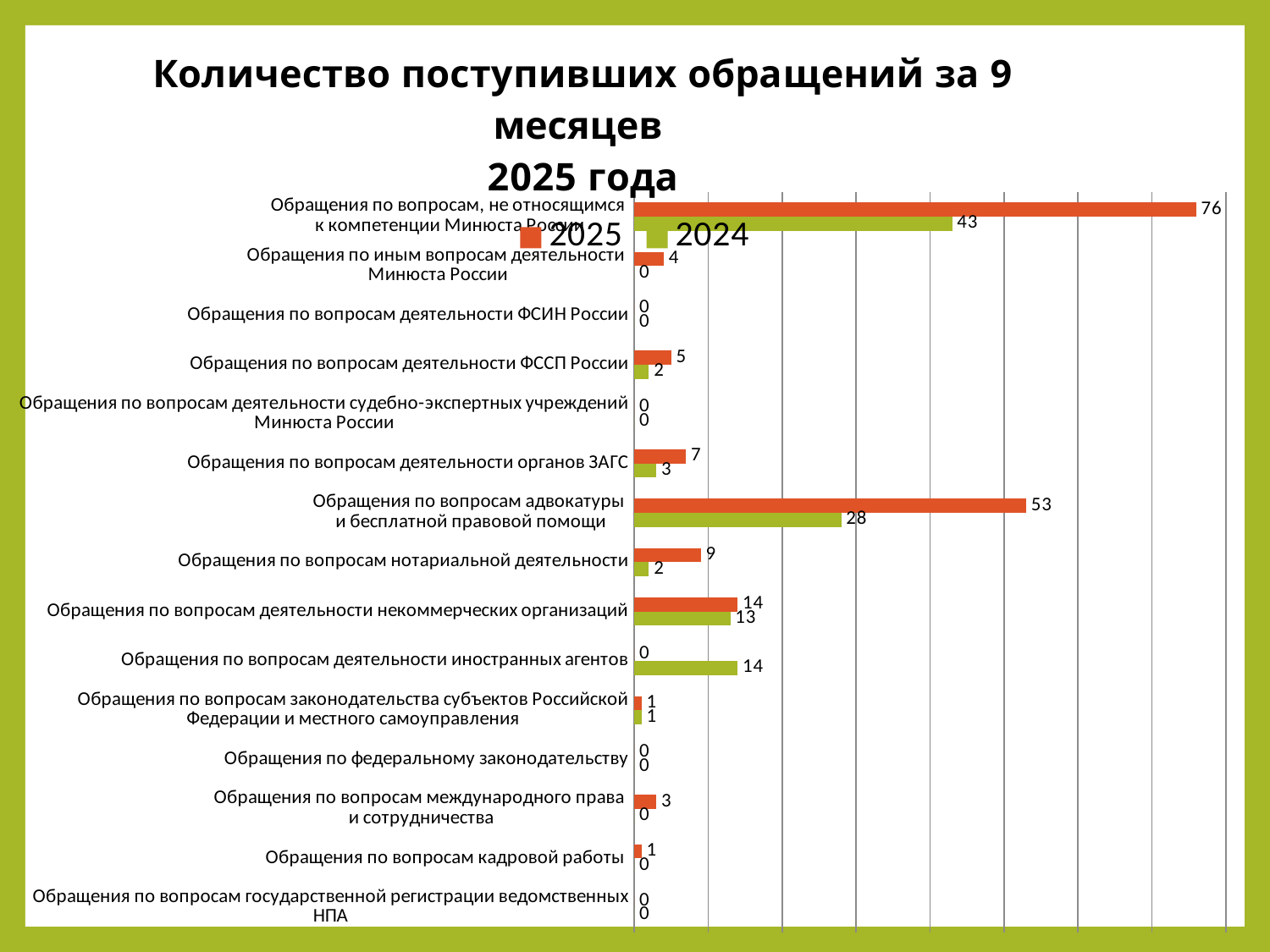
How many series does the legend list? 2 What is the difference between the 2025 and 2024 values for 'Обращения по вопросам адвокатуры и бесплатной правовой помощи'? 25 What is the 2024 value for 'Обращения по вопросам деятельности иностранных агентов'? 14 What is the 2025 value for 'Обращения по вопросам, не относящимся к компетенции Минюста России'? 76 What is the 2025 value for 'Обращения по вопросам деятельности органов ЗАГС'? 7 What is the 2024 value for 'Обращения по вопросам адвокатуры и бесплатной правовой помощи'? 28 What type of chart is shown on the slide? bar chart Which colour represents the 2025 series in the legend? orange What is the difference between the 2025 and 2024 values for 'Обращения по вопросам, не относящимся к компетенции Минюста России'? 33 How many categories are plotted on the chart? 15 Which category has the highest 2025 value? Обращения по вопросам, не относящимся к компетенции Минюста России For 'Обращения по вопросам деятельности иностранных агентов', which series has the larger value, 2025 or 2024? 2024